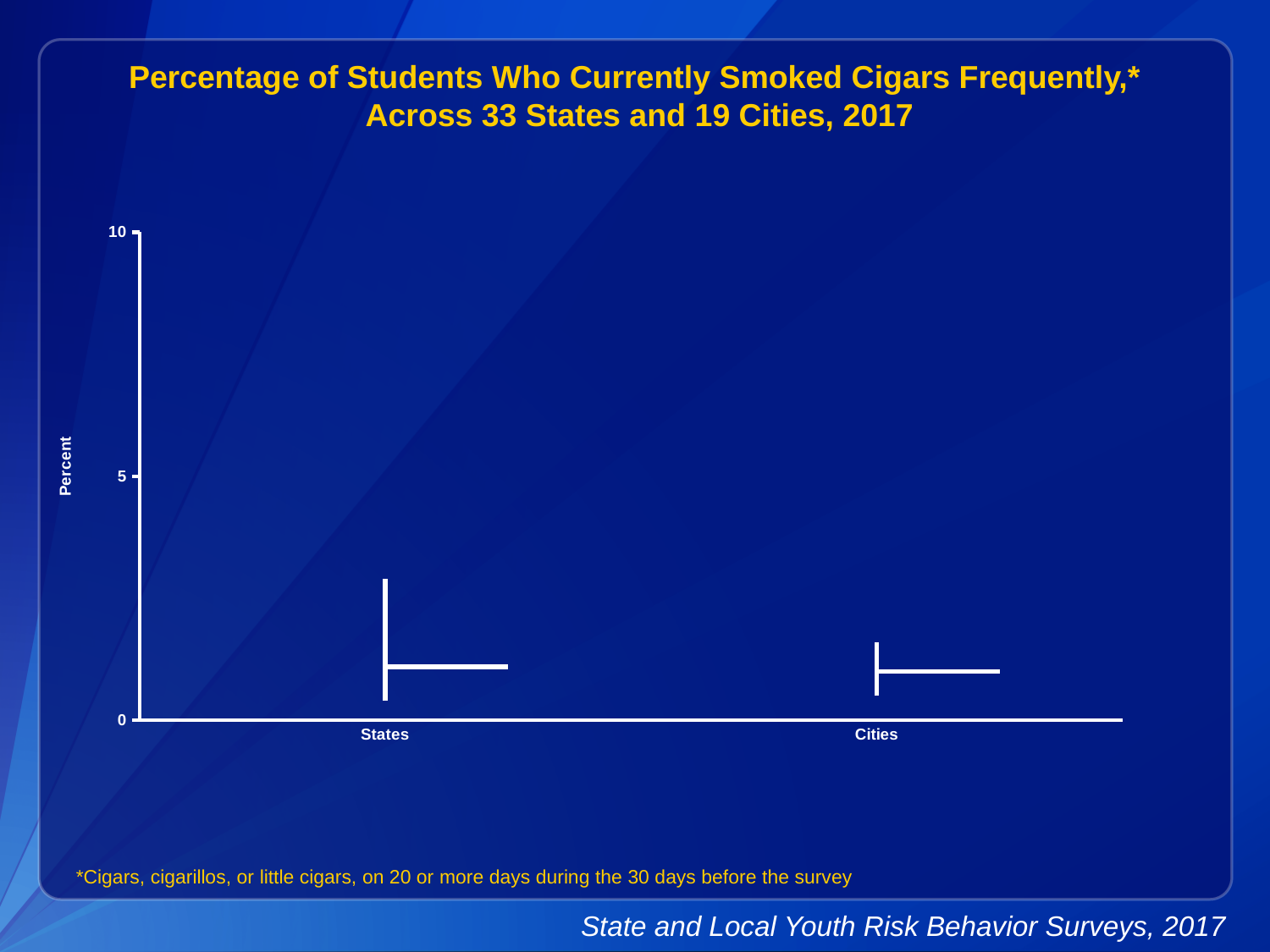
Is the lowest value in the range for Cities greater or less than 5? less What are the two categories shown on the x axis? States and Cities How many categories are shown on the x axis of the chart? 2 Which category has the higher top of its range, States or Cities? States What is the label on the y axis? Percent Is the highest value in the range for States greater or less than 5? less Is the median value for Cities greater or less than 5? less What is the maximum value shown on the y axis? 10